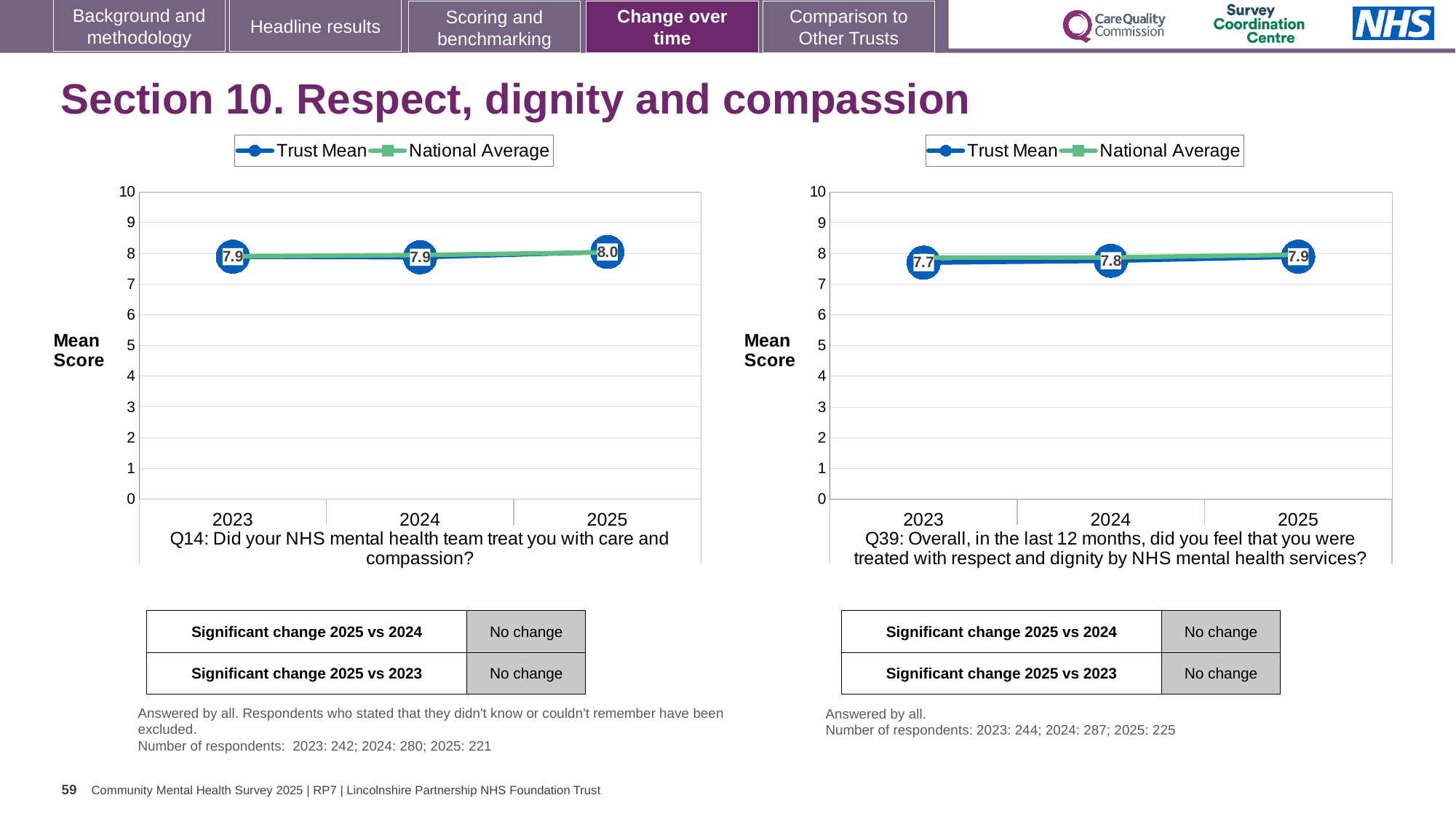
In the Q39 chart on the right, what is the Trust Mean score for 2024? 7.8 In the Q14 chart on the left, what is the Trust Mean score for 2023? 7.9 In the Q39 chart on the right, what is the Trust Mean score for 2023? 7.7 In the Q14 chart on the left, is the Trust Mean score for 2025 greater or less than 7? greater In the Q14 chart on the left, what is the Trust Mean score for 2025? 8.0 In the Q39 chart on the right, what is the difference between the Trust Mean scores for 2025 and 2023? 0.2 How many years are plotted on the x axis of the Q14 chart on the left? 3 In the Q39 chart on the right, does the Trust Mean score rise or fall from 2023 to 2025? Rise What type of chart is the Q14 chart on the left? Line chart How many series does the legend of the Q39 chart on the right list? 2 In the Q39 chart on the right, which year has the highest Trust Mean score? 2025 In the Q39 chart on the right, which year has the lowest Trust Mean score? 2023